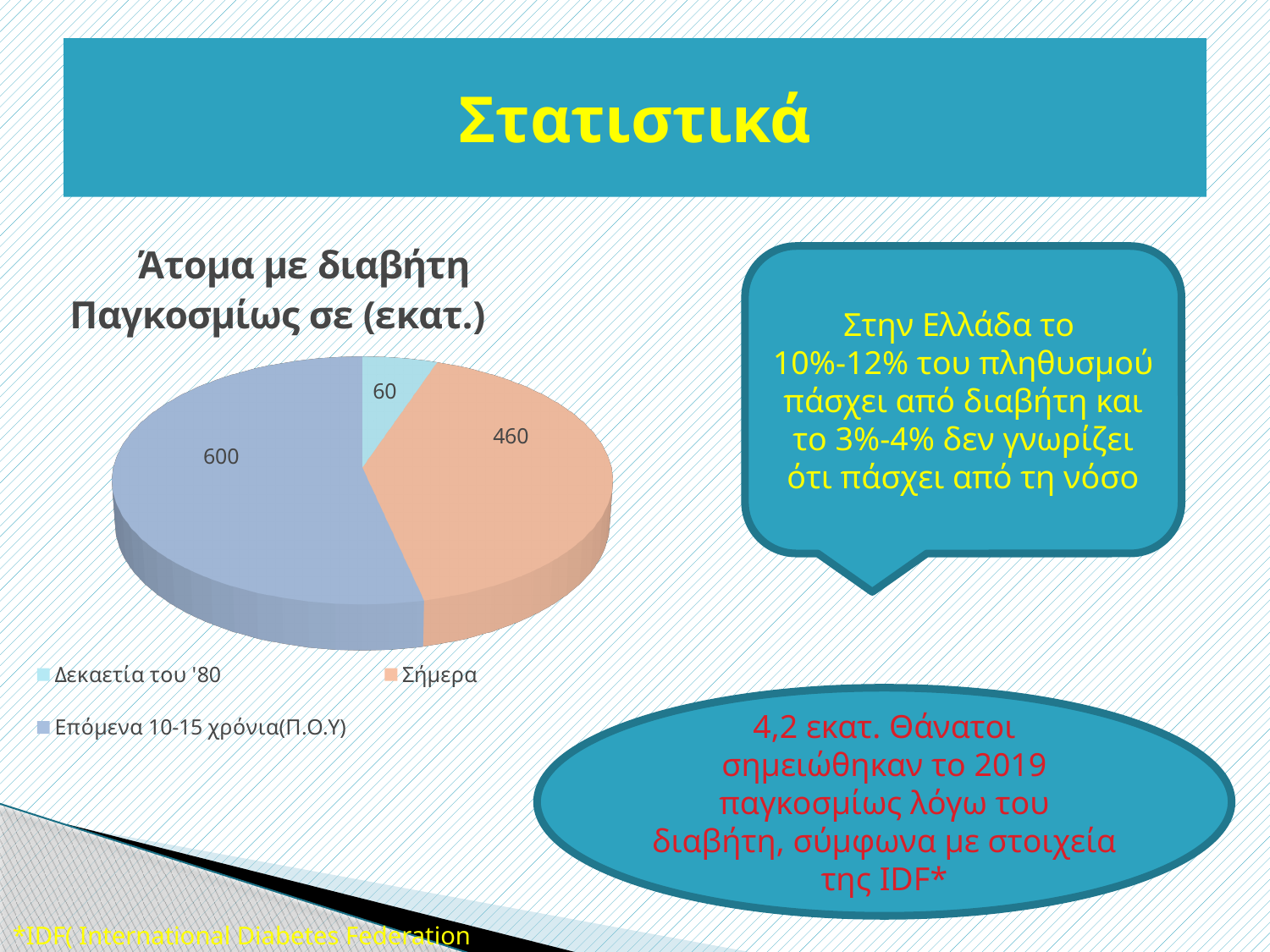
What is the value for Επόμενα 10-15 χρόνια(Π.Ο.Υ)? 600 What is the title of the pie chart? Άτομα με διαβήτη Παγκοσμίως σε (εκατ.) How many slices does the pie chart have? 3 What is the difference between the values for Σήμερα and Δεκαετία του '80? 400 What is the difference between the values for Επόμενα 10-15 χρόνια(Π.Ο.Υ) and Σήμερα? 140 Which category has the smallest slice of the pie? Δεκαετία του '80 Which category has the largest slice of the pie? Επόμενα 10-15 χρόνια(Π.Ο.Υ) Which is larger, the value for Σήμερα or the value for Δεκαετία του '80? Σήμερα What is the value for Δεκαετία του '80? 60 What colour is the slice for Σήμερα? Peach (light orange) What type of chart is shown on the slide? Pie chart What is the value for Σήμερα? 460